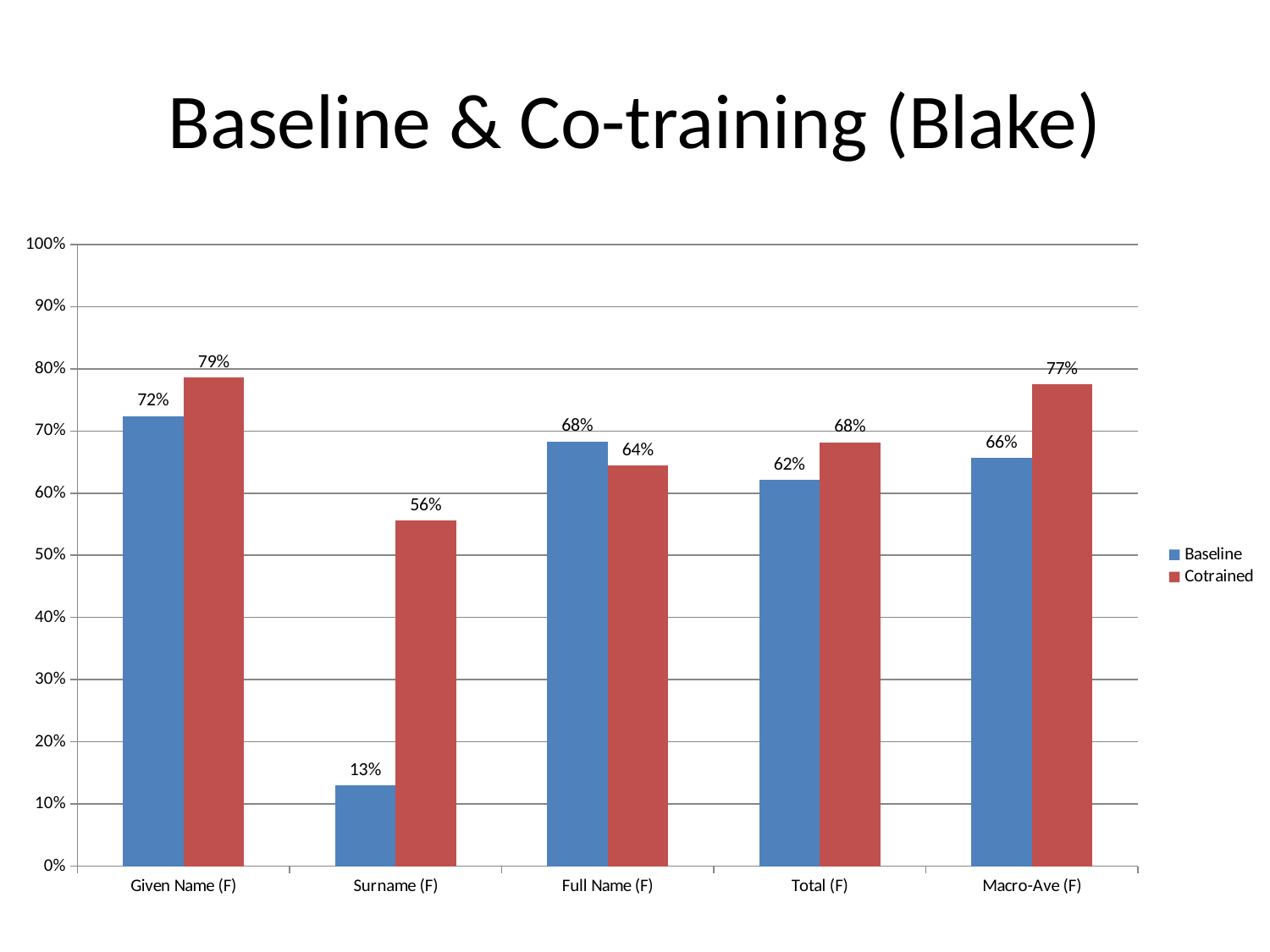
How many categories are shown on the x axis? 5 What is the difference between the Cotrained and Baseline values for Macro-Ave (F)? 11% Which category has the highest Cotrained value? Given Name (F) What is the Cotrained value for Surname (F)? 56% What is the Cotrained value for Macro-Ave (F)? 77% Is the Baseline value for Total (F) greater or less than 50%? greater How many series does the legend list? 2 What is the Baseline value for Given Name (F)? 72% For Full Name (F), which is larger: the Baseline value or the Cotrained value? Baseline What is the difference between the Cotrained and Baseline values for Surname (F)? 43% Which category has the lowest Baseline value? Surname (F) What kind of chart is shown on the slide? Bar chart